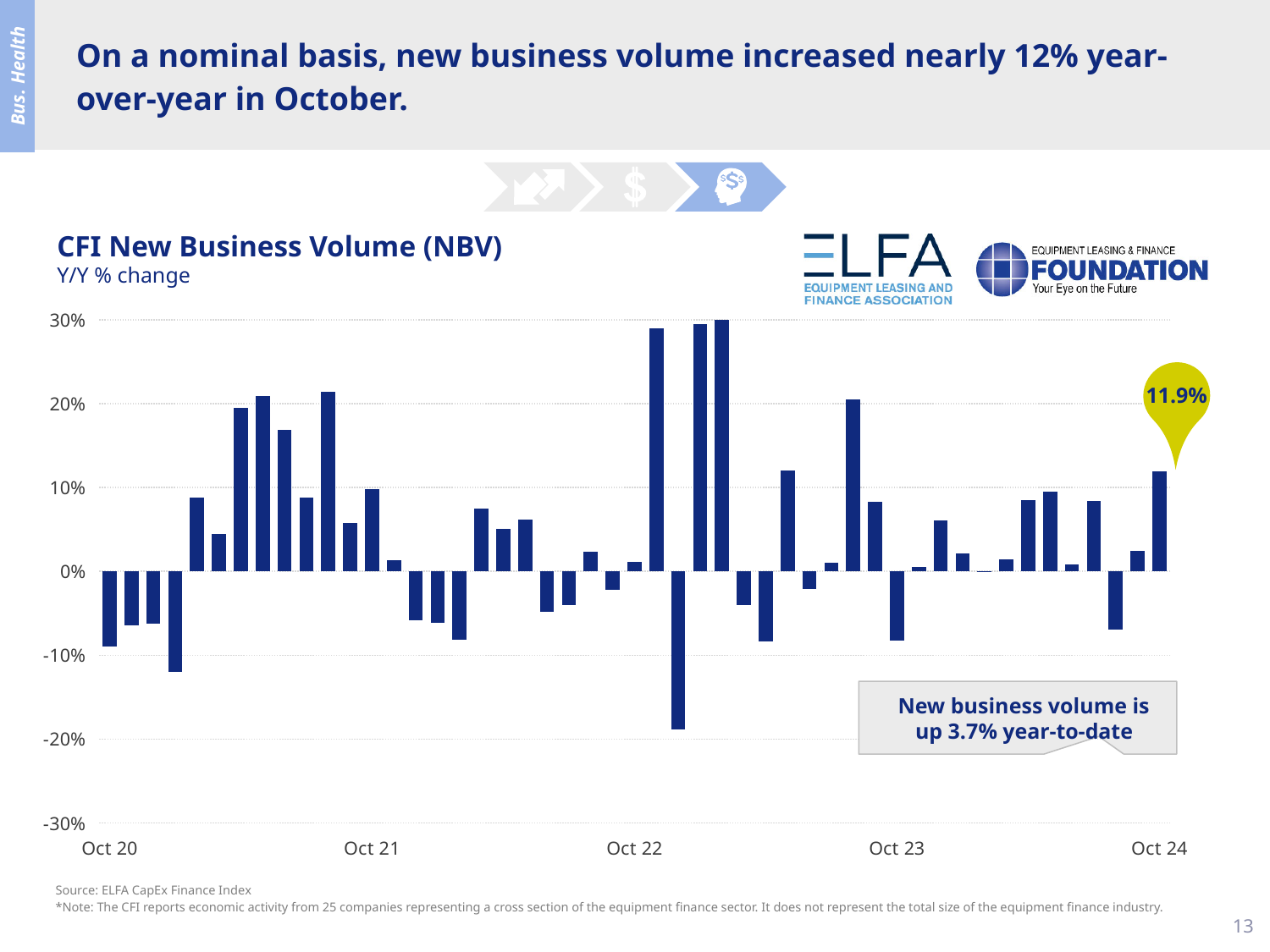
What is the title of the chart? CFI New Business Volume (NBV) Is the highest value on the chart greater or less than 20%? greater Which is larger, the value for Oct 20 or the value for Oct 24? Oct 24 Is the value for Oct 24 greater or less than 20%? less Is the value for Oct 20 greater or less than 0%? less What is the source cited for the chart? ELFA CapEx Finance Index What kind of chart is shown on the slide? bar chart How many labels are shown on the x axis of the chart? 5 What is the Y/Y % change in CFI New Business Volume for Oct 24? 11.9%